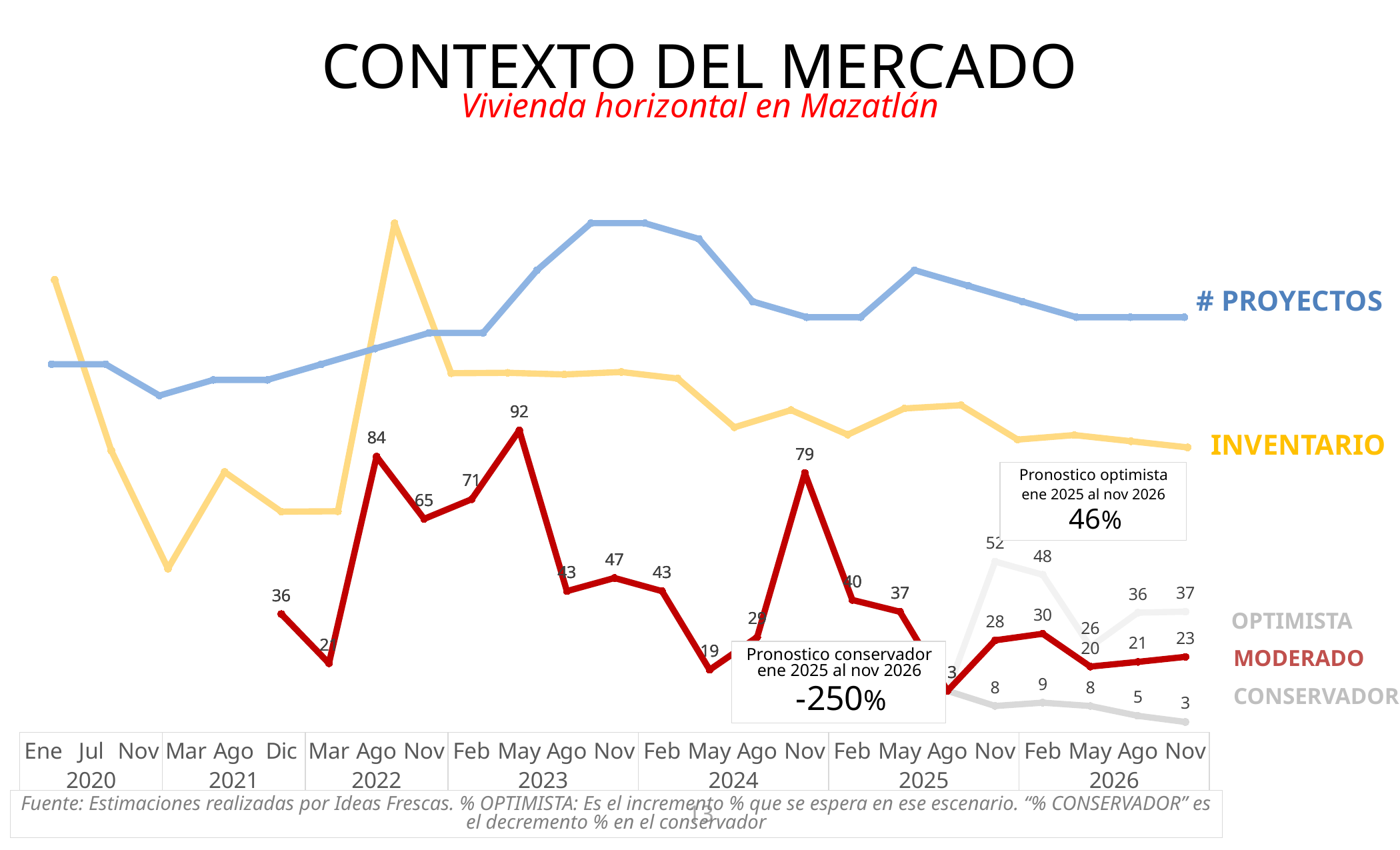
What is the lowest labelled value on the CONSERVADOR line? 3 Which is larger on the red line: the peak labelled 84 or the peak labelled 79? 84 What is the difference between the final OPTIMISTA value (37) and the final MODERADO value (23)? 14 What is the difference between the two highest labelled values on the red line, 92 and 84? 8 What percentage is given for the 'Pronostico conservador ene 2025 al nov 2026'? -250% What percentage is given for the 'Pronostico optimista ene 2025 al nov 2026'? 46% What is the lowest labelled value on the OPTIMISTA line? 26 What kind of chart is shown on the slide? line chart What is the highest labelled value on the red MODERADO line? 92 How many labelled data points does the OPTIMISTA line have? 5 What is the highest labelled value on the OPTIMISTA line? 52 What is the last labelled value of the MODERADO line at the right end of the chart? 23